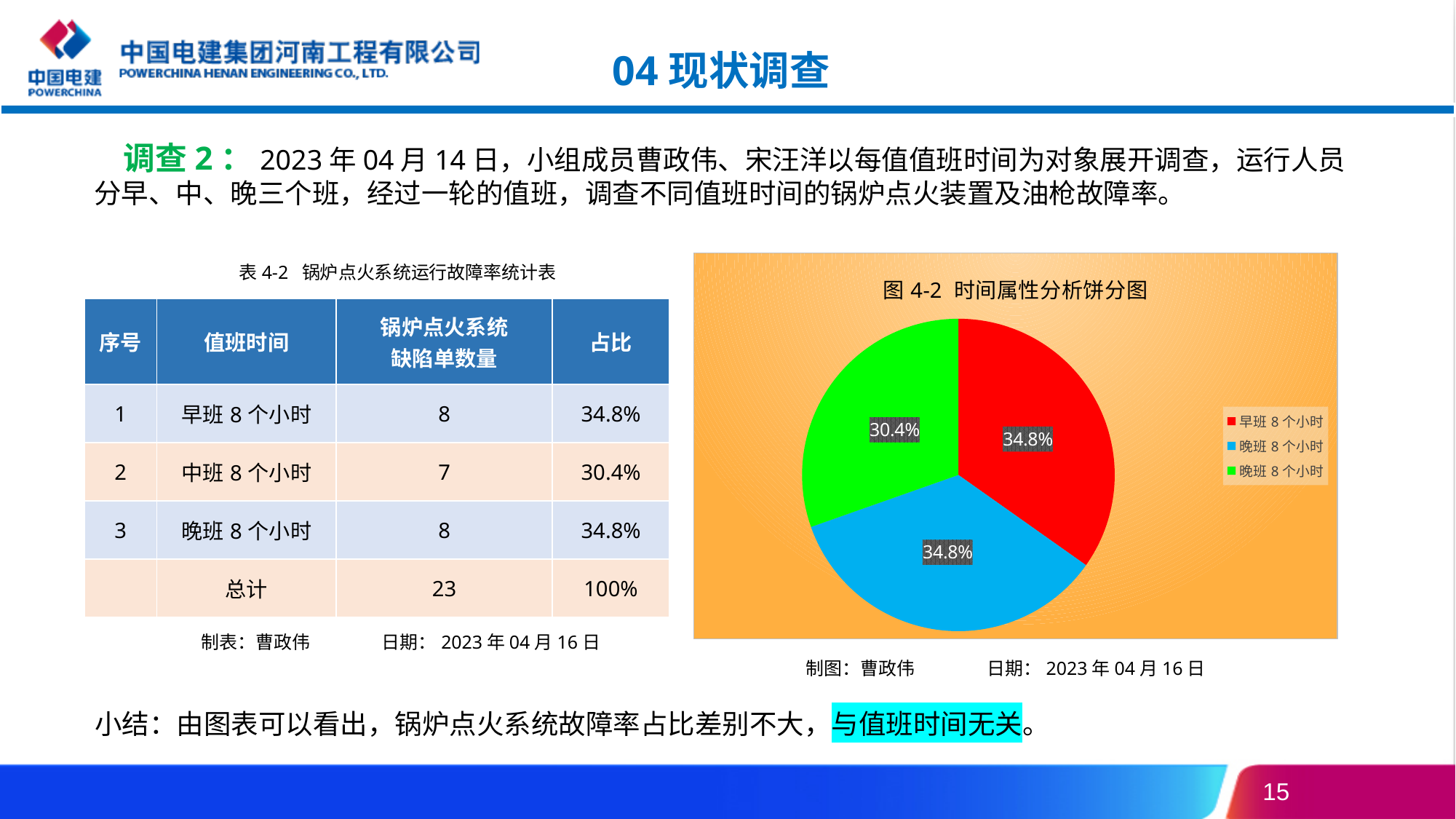
In the pie chart 图 4-2, what percentage is shown on the blue slice? 34.8% In the pie chart 图 4-2, what share does 早班 8 个小时 have? 34.8% What is the title of the pie chart on the slide? 图 4-2 时间属性分析饼分图 In the pie chart 图 4-2, what is the difference between the red slice and the green slice? 4.4% In the pie chart 图 4-2, how many slices does the pie have? 3 In the pie chart 图 4-2, how many entries does the legend list? 3 In the pie chart 图 4-2, what percentage is shown on the red slice? 34.8% In the pie chart 图 4-2, what colour represents 早班 8 个小时? red What kind of chart is shown in 图 4-2? pie chart In the pie chart 图 4-2, which is larger, the red slice or the green slice? the red slice In the pie chart 图 4-2, what percentage is shown on the green slice? 30.4% In the pie chart 图 4-2, which slice is the smallest? the green slice (30.4%)